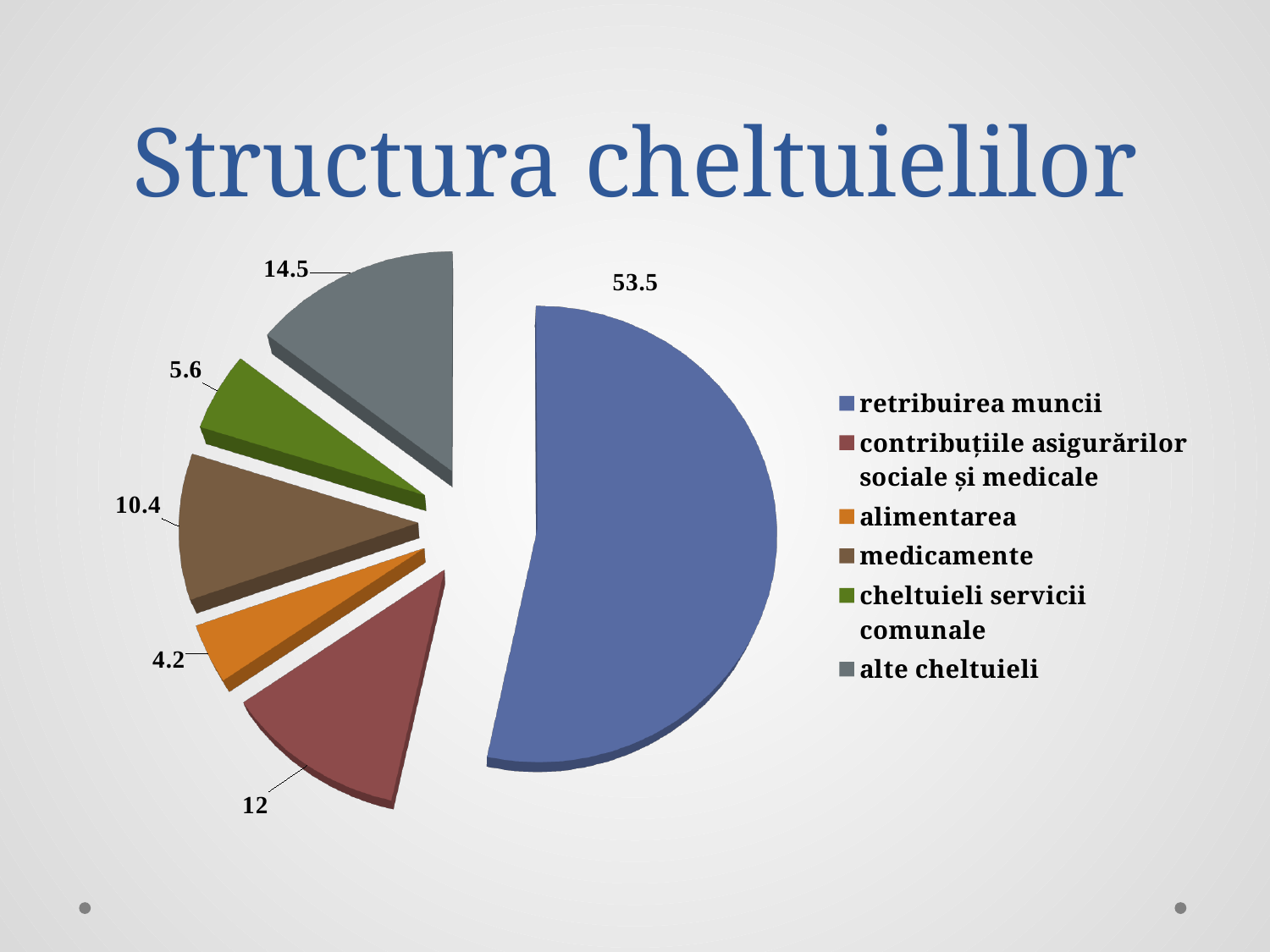
What is the value for contribuțiile asigurărilor sociale și medicale? 12 What is the difference between the values for alte cheltuieli and medicamente? 4.1 Which category has the largest slice of the pie? retribuirea muncii What is the value for retribuirea muncii? 53.5 Which is larger, the value for cheltuieli servicii comunale or the value for alimentarea? cheltuieli servicii comunale What is the value for alte cheltuieli? 14.5 How many categories does the pie chart have? 6 Which category has the smallest slice of the pie? alimentarea What is the value for medicamente? 10.4 What is the value for alimentarea? 4.2 What is the title of the slide containing the chart? Structura cheltuielilor What type of chart is shown on the slide? pie chart